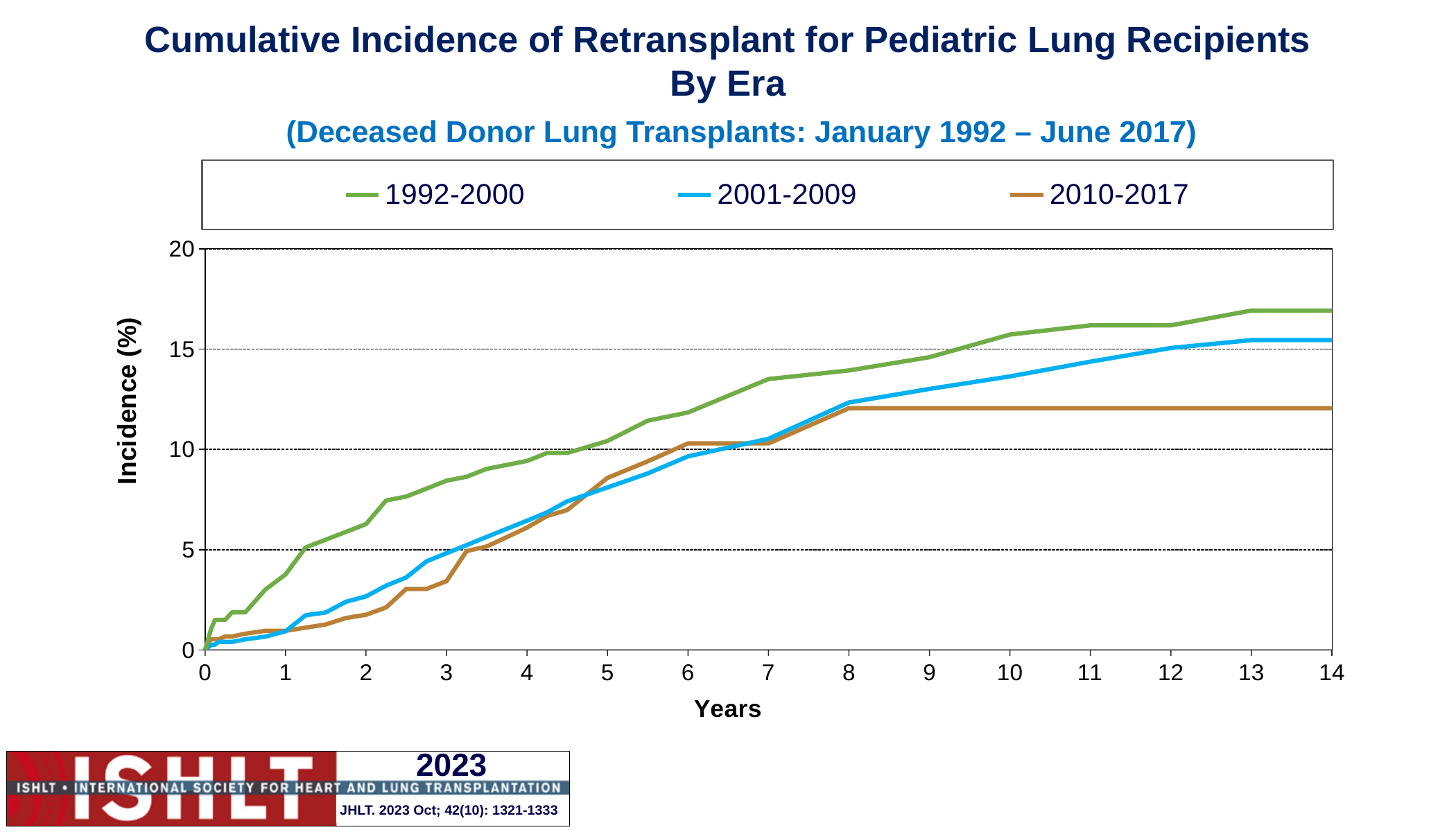
Is the value for 1992-2000 at 7 years greater or less than 10? greater At 10 years, which is larger: the value for 2001-2009 or the value for 2010-2017? 2001-2009 What is the label of the y axis? Incidence (%) Which era has the highest cumulative incidence at 14 years? 1992-2000 How many series does the legend list? 3 Which era has the lowest cumulative incidence at 14 years? 2010-2017 Is the value for 1992-2000 at 14 years greater or less than 15? greater Is the value for 2010-2017 at 14 years greater or less than 15? less Does the cumulative incidence for 1992-2000 rise or fall as years increase? rise What kind of chart is shown on the slide? line chart Which eras are listed in the legend? 1992-2000, 2001-2009, 2010-2017